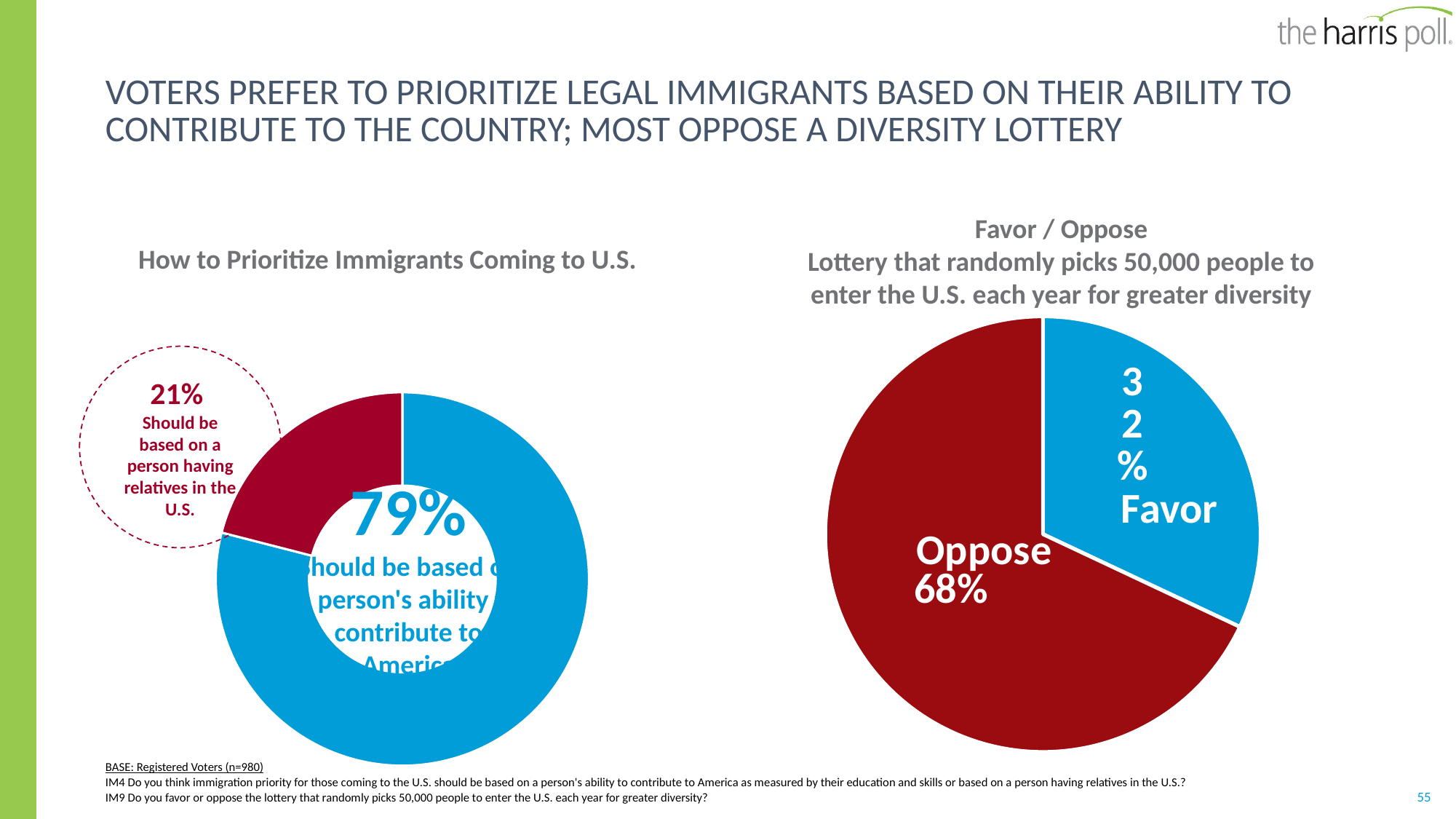
In the 'How to Prioritize Immigrants Coming to U.S.' chart, what share of voters say priority should be based on a person having relatives in the U.S.? 21% In the 'Favor / Oppose' lottery chart, what colour is the Oppose slice? Red In the 'Favor / Oppose' lottery chart, is the Favor share greater or less than 50%? less In the 'How to Prioritize Immigrants Coming to U.S.' chart, which option has the smaller share? Should be based on a person having relatives in the U.S. How many slices does the 'Favor / Oppose' lottery chart have? 2 In the 'Favor / Oppose' lottery chart, what is the difference in percentage points between Oppose and Favor? 36 In the 'How to Prioritize Immigrants Coming to U.S.' chart, how many percentage points separate the two options? 58 In the 'Favor / Oppose' lottery chart, what percentage of voters oppose the lottery? 68% What kind of chart is the 'Favor / Oppose' lottery chart on the right? Pie chart In the 'How to Prioritize Immigrants Coming to U.S.' chart, what share of voters say priority should be based on a person's ability to contribute to America? 79% In the 'Favor / Oppose' lottery chart, which response is larger, Favor or Oppose? Oppose In the 'Favor / Oppose' lottery chart, what percentage of voters favor the lottery? 32%